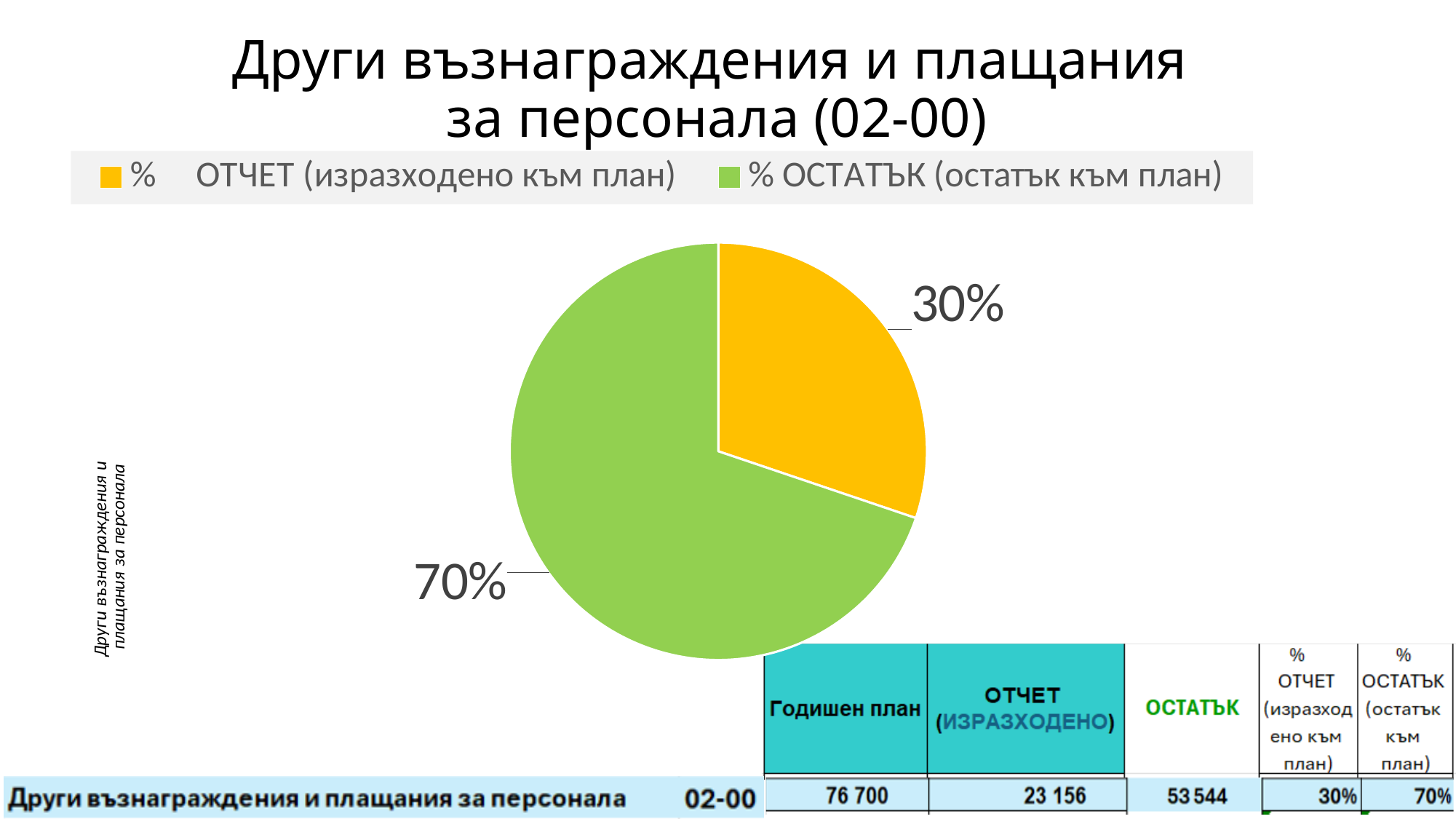
Which is larger: the "% ОТЧЕТ" slice or the "% ОСТАТЪК" slice? % ОСТАТЪК Which slice of the pie is the smallest? % ОТЧЕТ (изразходено към план) What is the title of the slide containing the pie chart? Други възнаграждения и плащания за персонала (02-00) What is the difference in percentage points between the "% ОСТАТЪК" slice and the "% ОТЧЕТ" slice? 40 What share of the pie does the "% ОТЧЕТ (изразходено към план)" slice represent? 30% What share of the pie does the "% ОСТАТЪК (остатък към план)" slice represent? 70% How many entries does the legend list? 2 What colour is the "% ОТЧЕТ (изразходено към план)" slice? yellow Which slice of the pie is the largest? % ОСТАТЪК (остатък към план) What kind of chart is shown on the slide? pie chart What colour is the "% ОСТАТЪК (остатък към план)" slice? green How many slices does the pie chart have? 2